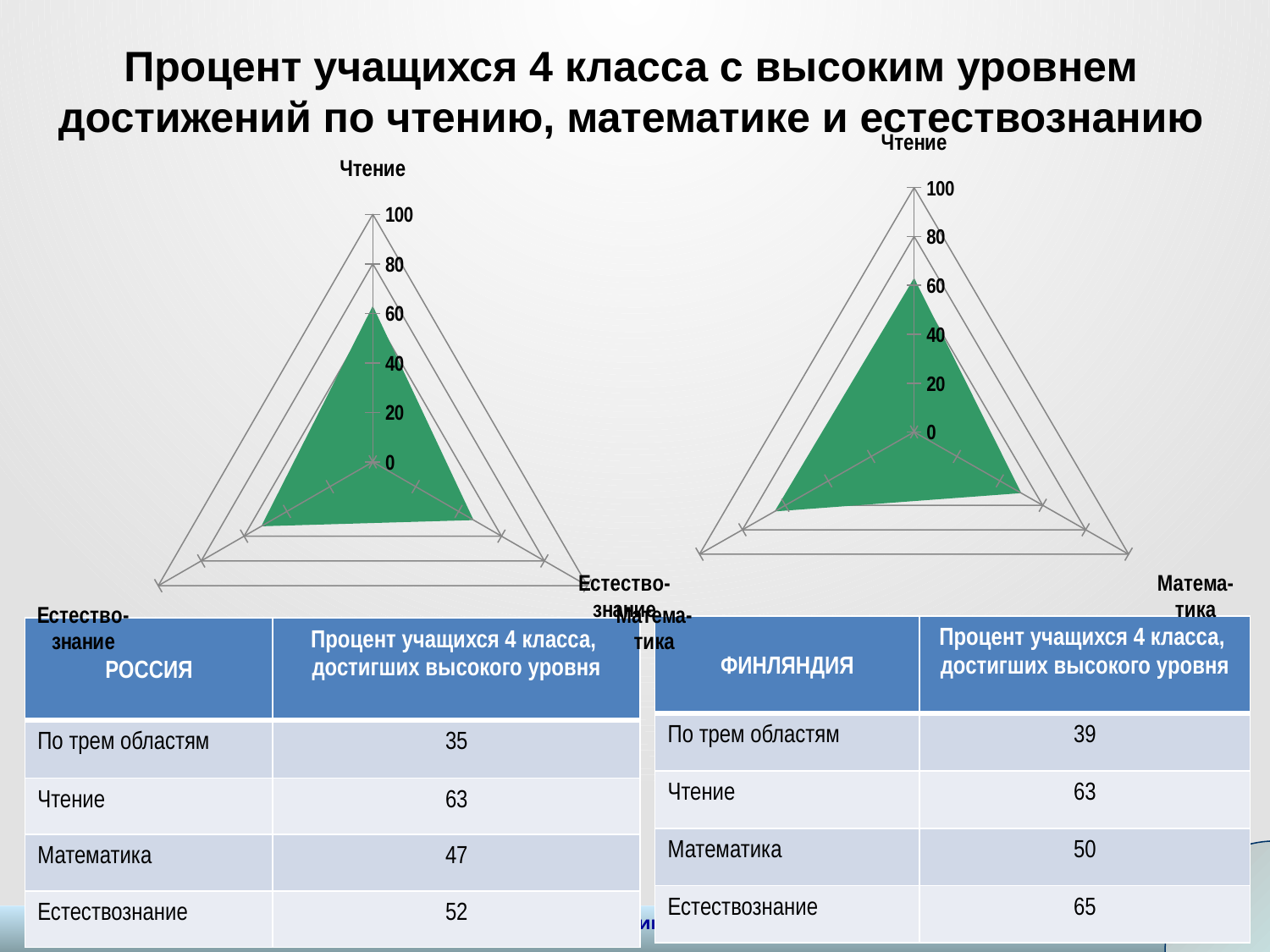
How many categories (axes) does the left radar chart have? 3 On the right radar chart (Финляндия), is the value for Естествознание greater or less than 40? greater Which category is placed at the top vertex of both radar charts? Чтение On the left radar chart (Россия), which category has the highest value? Чтение On the left radar chart (Россия), is the value for Чтение greater or less than 80? less On the right radar chart (Финляндия), which is larger: the value for Естествознание or the value for Математика? Естествознание On the left radar chart (Россия), which is larger: the value for Чтение or the value for Математика? Чтение On the right radar chart (Финляндия), is the value for Чтение greater or less than 80? less What kind of chart is shown on the left side of the slide? radar chart What is the maximum value shown on the axis scale of the radar charts? 100 On the right radar chart (Финляндия), which category has the lowest value? Математика